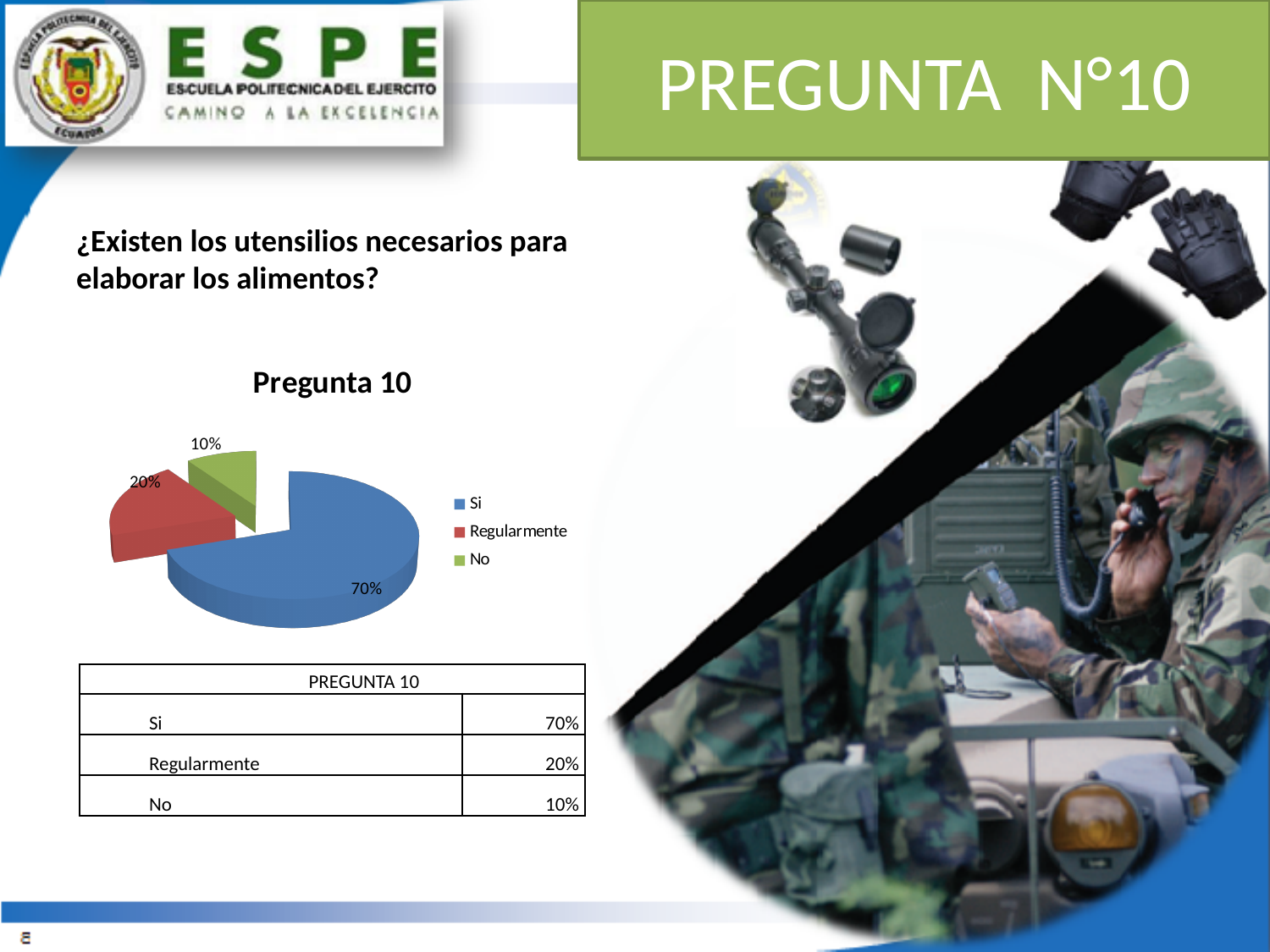
How many slices does the pie chart have? 3 What is the title of the chart? Pregunta 10 Which category has the largest slice in the pie chart? Si What percentage of the pie chart is the 'Si' slice? 70% What percentage of the pie chart is the 'Regularmente' slice? 20% Which slice is larger, 'Regularmente' or 'No'? Regularmente Which category has the smallest slice in the pie chart? No What type of chart is shown on the slide? pie chart What percentage of the pie chart is the 'No' slice? 10% How many entries does the legend of the pie chart list? 3 What colour is the 'Si' slice in the pie chart? blue What is the difference in percentage points between the 'Si' slice and the 'Regularmente' slice? 50%